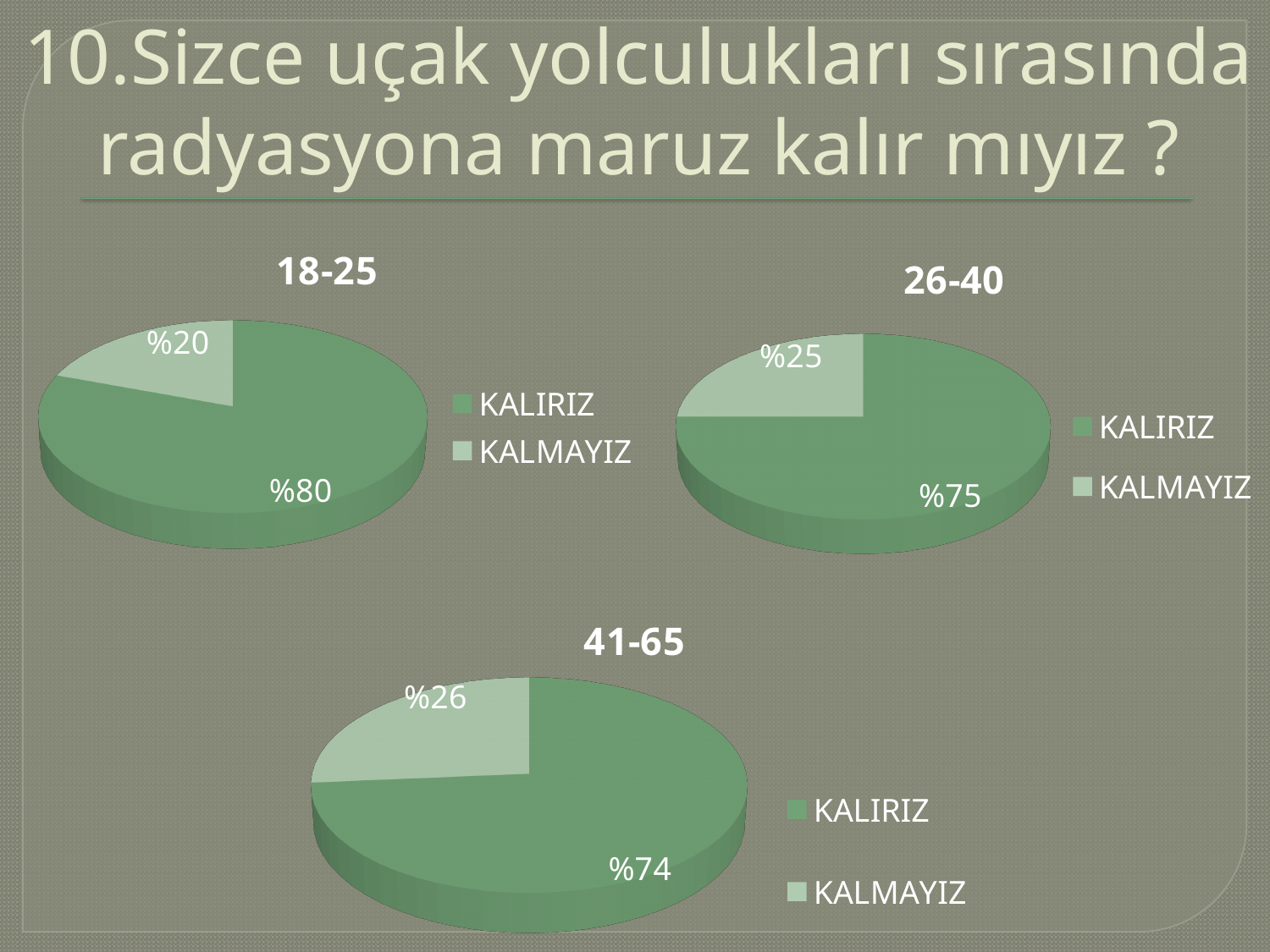
What kind of chart is the chart titled "41-65"? Pie chart In the chart titled "26-40", what is the value for KALMAYIZ? %25 In the chart titled "18-25", what is the value for KALIRIZ? %80 How many slices does the chart titled "26-40" have? 2 In the chart titled "41-65", what is the value for KALIRIZ? %74 In the chart titled "26-40", what is the difference between the KALIRIZ and KALMAYIZ values? %50 In the chart titled "41-65", which category has the smallest slice? KALMAYIZ In the chart titled "18-25", what is the value for KALMAYIZ? %20 In the chart titled "26-40", what is the value for KALIRIZ? %75 In the chart titled "18-25", which is larger, KALIRIZ or KALMAYIZ? KALIRIZ In the chart titled "18-25", which category has the largest slice? KALIRIZ In the chart titled "41-65", what is the value for KALMAYIZ? %26